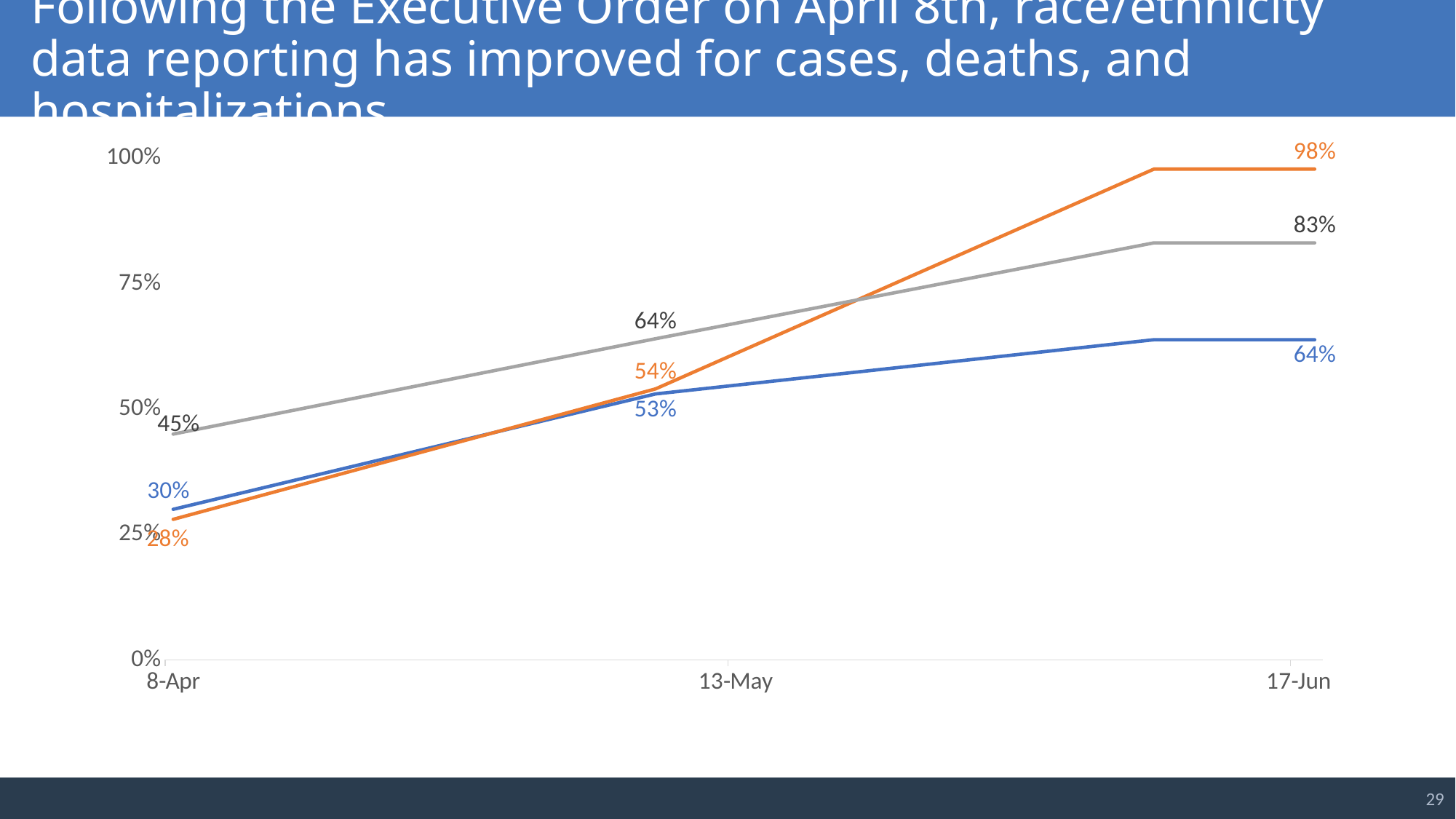
On 13-May, which is larger: the grey line's value or the orange line's value? the grey line's value How many dates are labelled on the x axis of the chart? 3 What is the value of the blue line on 13-May? 53% Which line has the highest value on 17-Jun? the orange line Does the blue line rise or fall from 8-Apr to 17-Jun? rise What is the last date shown on the x axis of the chart? 17-Jun What is the value of the grey line on 8-Apr? 45% What is the value of the orange line on 17-Jun? 98% What type of chart is shown on the slide? line chart Which line has the lowest value on 8-Apr? the orange line How many lines are plotted on the chart? 3 What is the difference between the orange line's value on 17-Jun and its value on 8-Apr? 70%